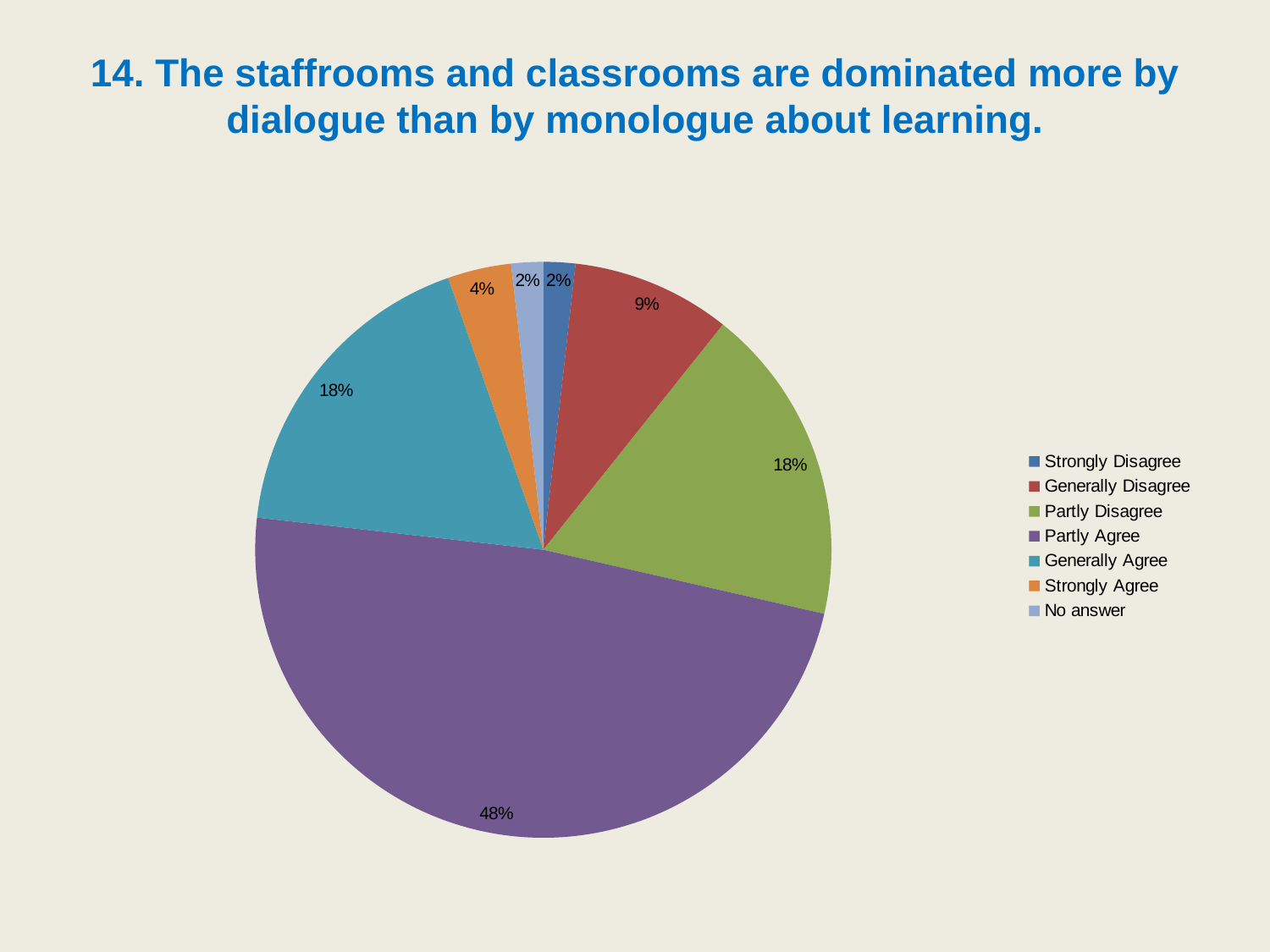
What percentage of respondents chose Partly Agree? 48% Which response category has the largest share of the pie? Partly Agree How many response categories does the legend list? 7 What is the combined share of Strongly Disagree and No answer? 4% Which is larger, the share for Generally Disagree or the share for Strongly Agree? Generally Disagree What percentage of respondents chose Strongly Agree? 4% What percentage of respondents chose Generally Disagree? 9% What kind of chart is shown on the slide? Pie chart What is the difference in percentage points between Partly Agree and Generally Agree? 30 What is the difference in percentage points between Generally Disagree and Strongly Agree? 5 What percentage of respondents chose Partly Disagree? 18% Which colour represents Partly Agree in the chart? Purple